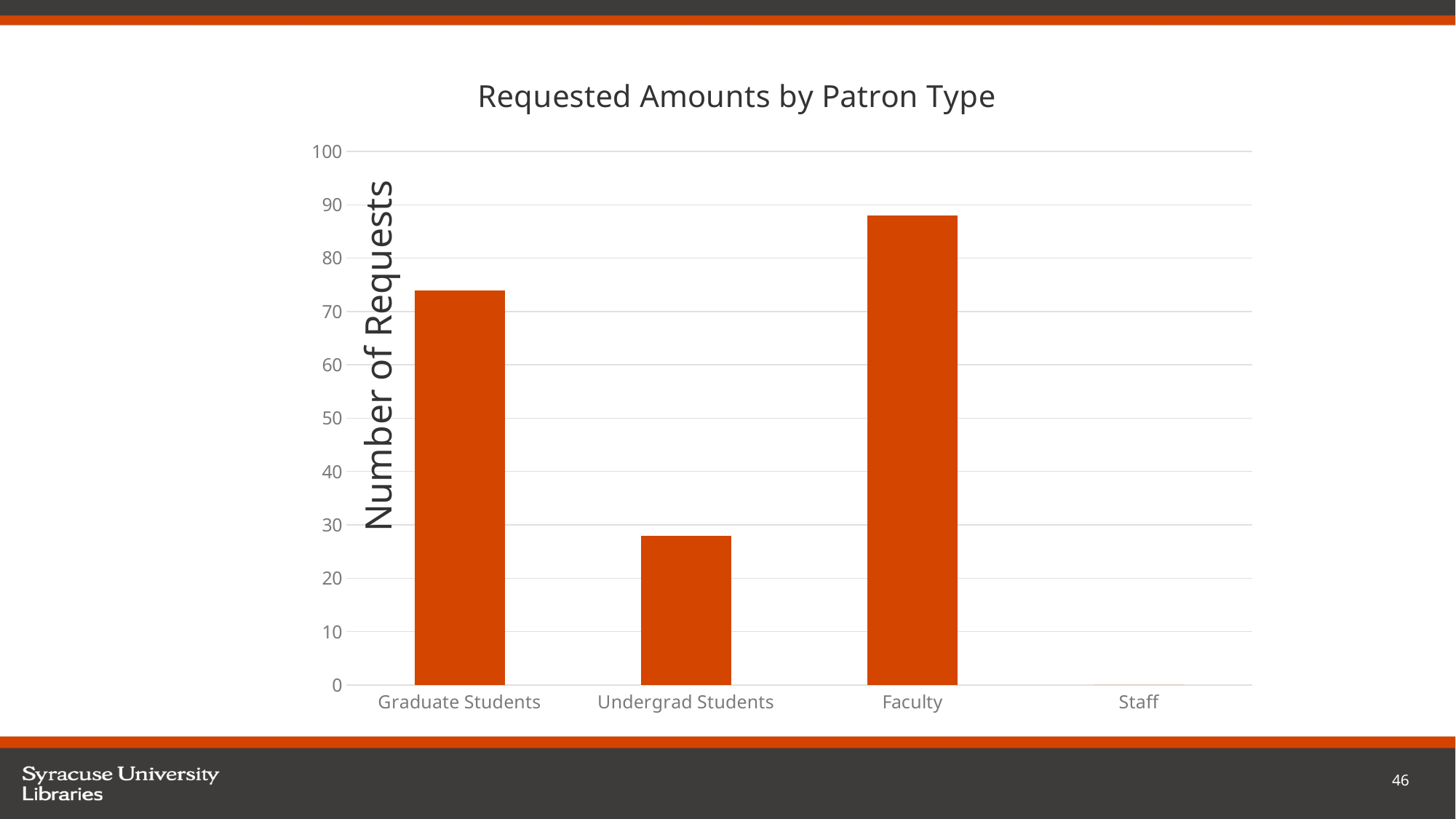
How many patron type categories are shown on the x axis? 4 What is the label on the vertical axis of the chart? Number of Requests What is the title of the chart? Requested Amounts by Patron Type Which patron type has the highest number of requests? Faculty Is the value for Staff greater or less than 10? less Is the value for Undergrad Students greater or less than 30? less Is the value for Graduate Students greater or less than 70? greater Which patron type has the lowest number of requests? Staff Which has more requests, Graduate Students or Undergrad Students? Graduate Students Which has more requests, Faculty or Graduate Students? Faculty What type of chart is shown on the slide? bar chart